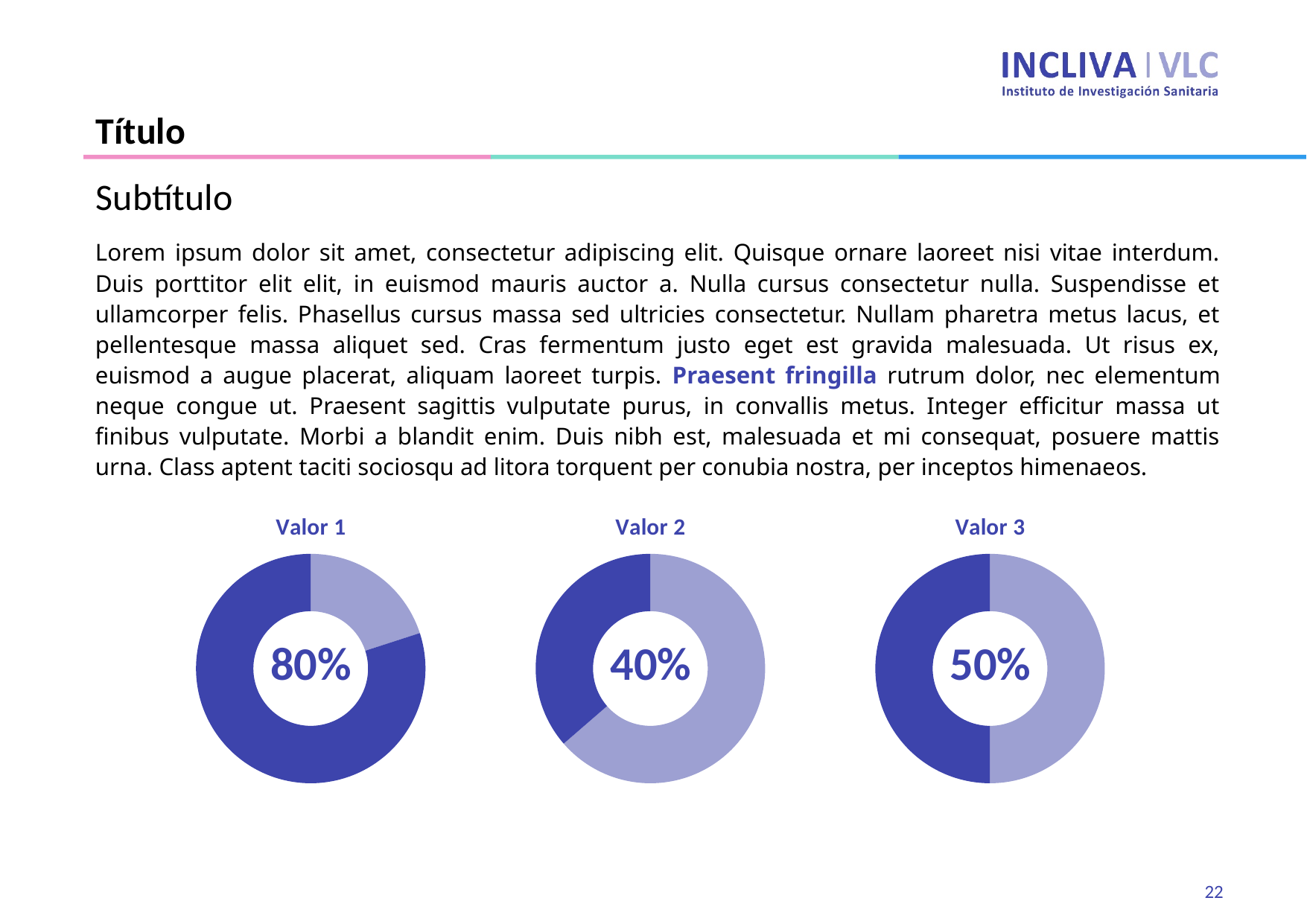
What value is shown in the centre of the Valor 2 chart? 40% What kind of chart is used for Valor 1, Valor 2 and Valor 3? Donut chart How many donut charts are shown on the slide? 3 Which is larger, the percentage for Valor 2 or the percentage for Valor 3? Valor 3 Which of the three charts (Valor 1, Valor 2, Valor 3) shows the lowest percentage? Valor 2 In the Valor 3 chart, what share of the ring is filled by the dark blue segment? 50% What value is shown in the centre of the Valor 3 chart? 50% What value is shown in the centre of the Valor 1 chart? 80% What is the difference between the percentage shown for Valor 1 and the percentage shown for Valor 2? 40% Which of the three charts (Valor 1, Valor 2, Valor 3) shows the highest percentage? Valor 1 What is the difference between the percentage shown for Valor 3 and the percentage shown for Valor 2? 10% What are the titles of the three charts, from left to right? Valor 1, Valor 2, Valor 3